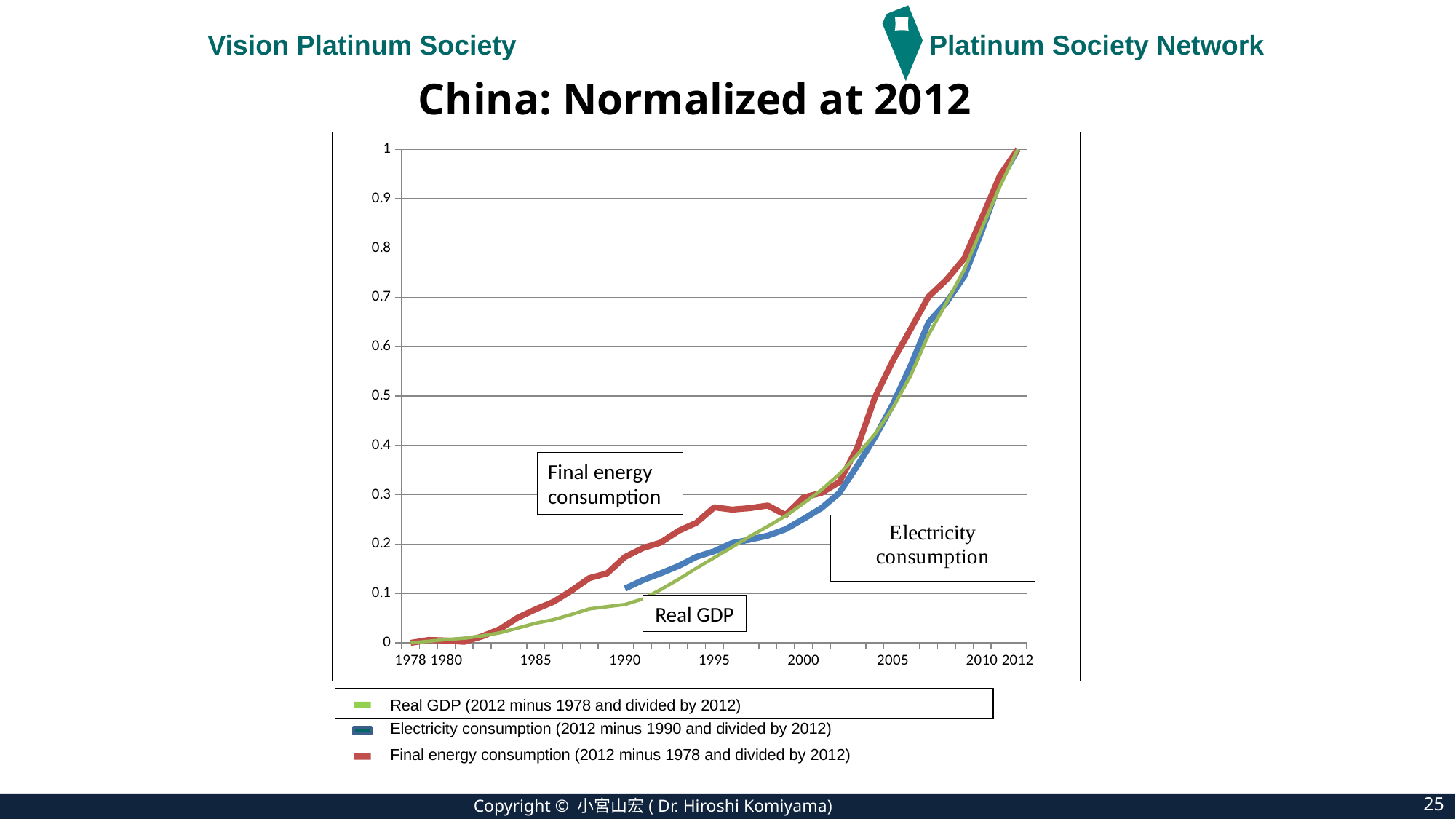
Is the value for Final energy consumption in 1995 greater or less than 0.2? greater In 1990, which is larger: Final energy consumption or Real GDP? Final energy consumption What is the title of the chart? China: Normalized at 2012 Is the value for Final energy consumption in 2010 greater or less than 0.8? greater Is the value for Real GDP in 1990 greater or less than 0.1? less What is the value of Real GDP in 2012? 1 Which series in the legend starts in 1990 rather than 1978? Electricity consumption In 1995, which is larger: Final energy consumption or Real GDP? Final energy consumption What kind of chart is shown on the slide? Line chart How many series does the legend list? 3 Do the values of Real GDP rise or fall from 1978 to 2012? Rise What is the value of Final energy consumption in 2012? 1